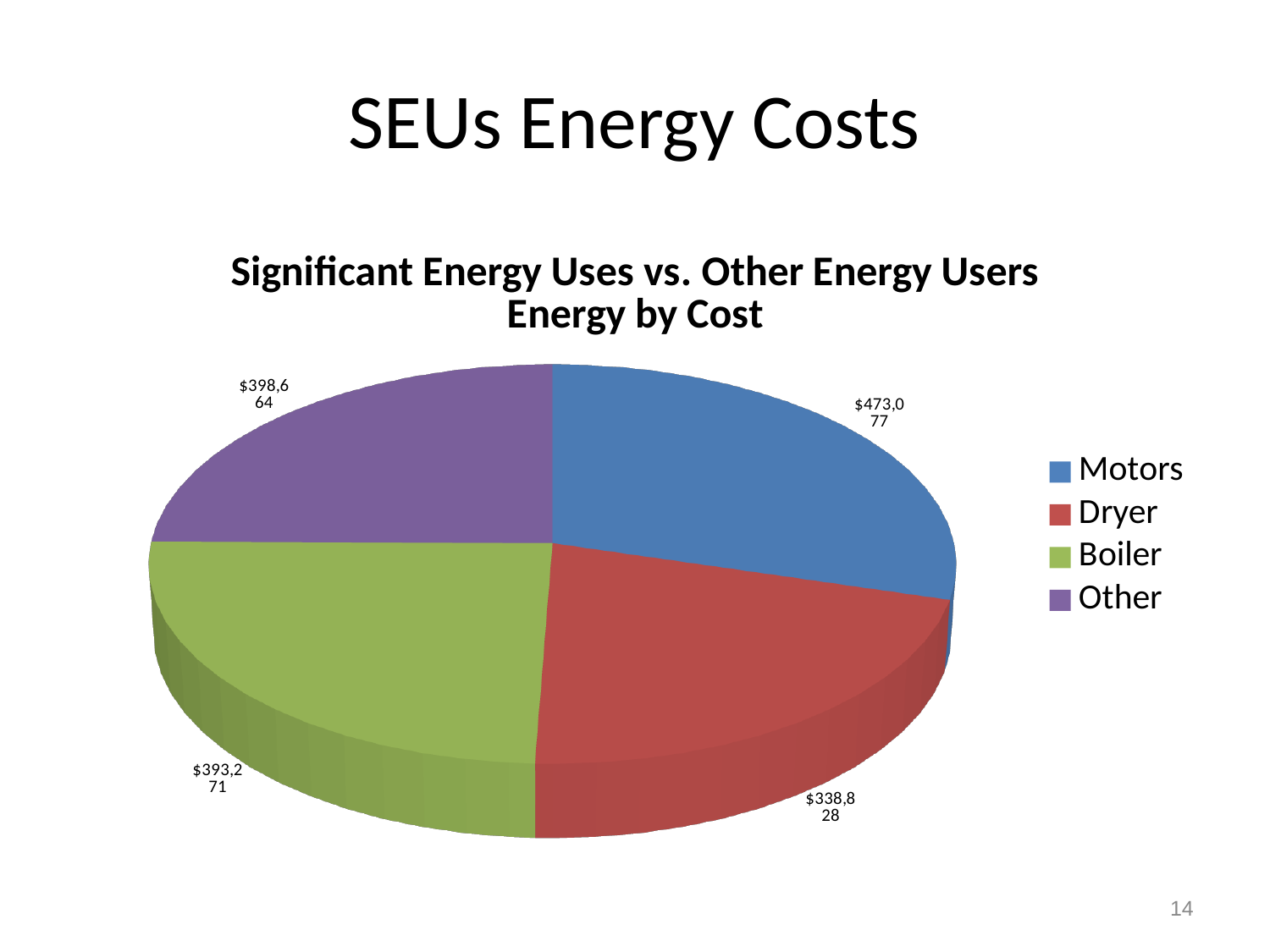
What is the difference between the energy cost for Motors and the energy cost for Boiler? $79,806 What is the energy cost for Motors? $473,077 What is the title of the chart? Significant Energy Uses vs. Other Energy Users Energy by Cost Which has a larger energy cost, Motors or Boiler? Motors What is the energy cost for Other? $398,664 Which category has the lowest energy cost? Dryer What is the energy cost for Dryer? $338,828 What is the difference between the energy cost for Motors and the energy cost for Dryer? $134,249 What is the energy cost for Boiler? $393,271 What kind of chart is shown on the slide? Pie chart Which category has the highest energy cost? Motors How many categories does the pie chart show? 4